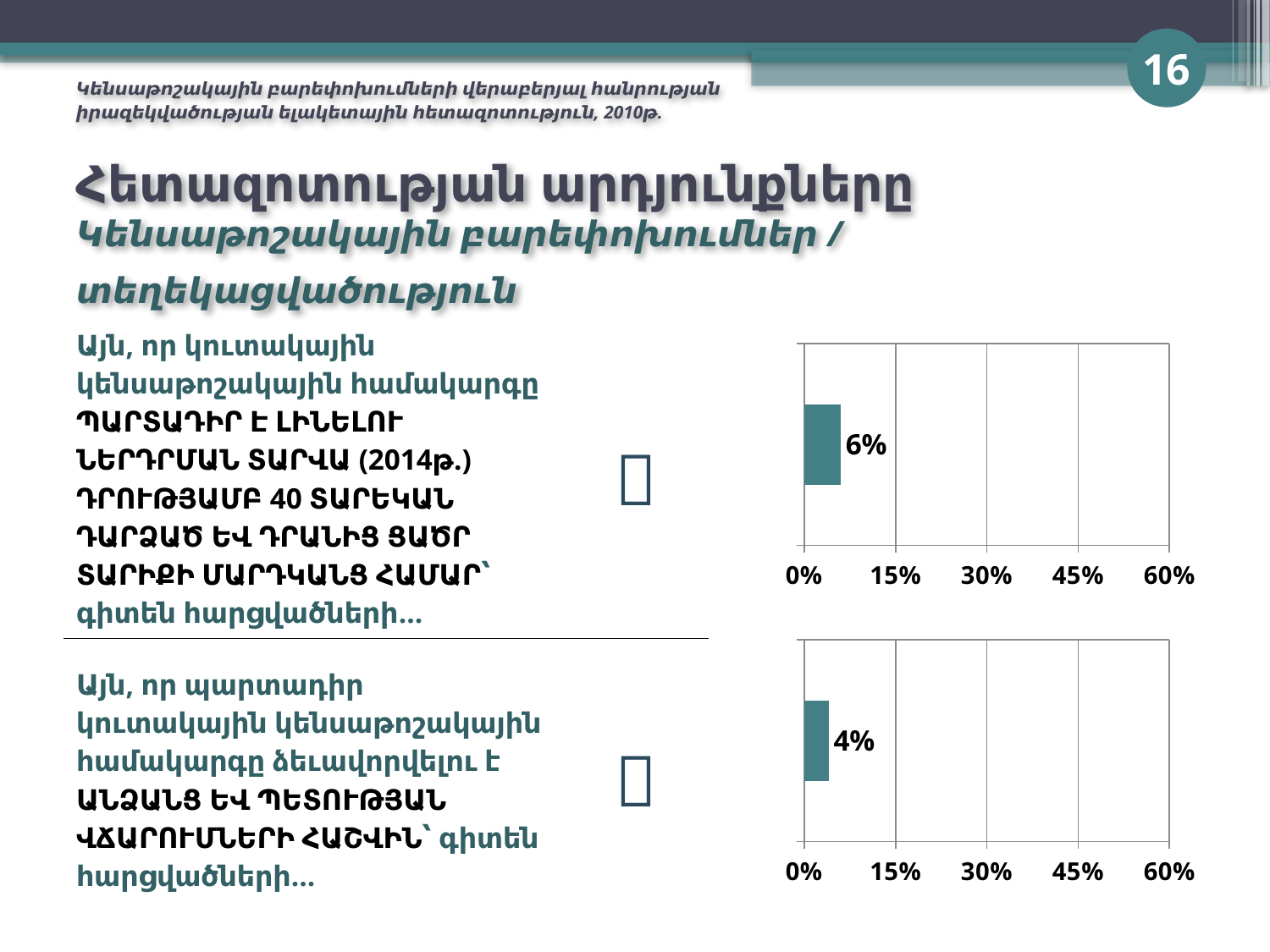
In the bottom chart, is the value of the bar greater or less than 15%? less What kind of chart is the top chart on the right? bar chart What is the maximum value shown on the horizontal axis of the top chart? 60% Which is larger: the bar in the top chart or the bar in the bottom chart? the bar in the top chart How many bars are plotted in the bottom chart? 1 What is the interval between the tick labels on the horizontal axis of the bottom chart? 15% In the bottom chart on the right, what value is shown on the bar? 4% In the top chart on the right, what value is shown on the bar? 6% What kind of chart is the bottom chart on the right? bar chart What is the difference between the value in the top chart and the value in the bottom chart? 2% How many bars are plotted in the top chart? 1 In the top chart, is the value of the bar greater or less than 15%? less